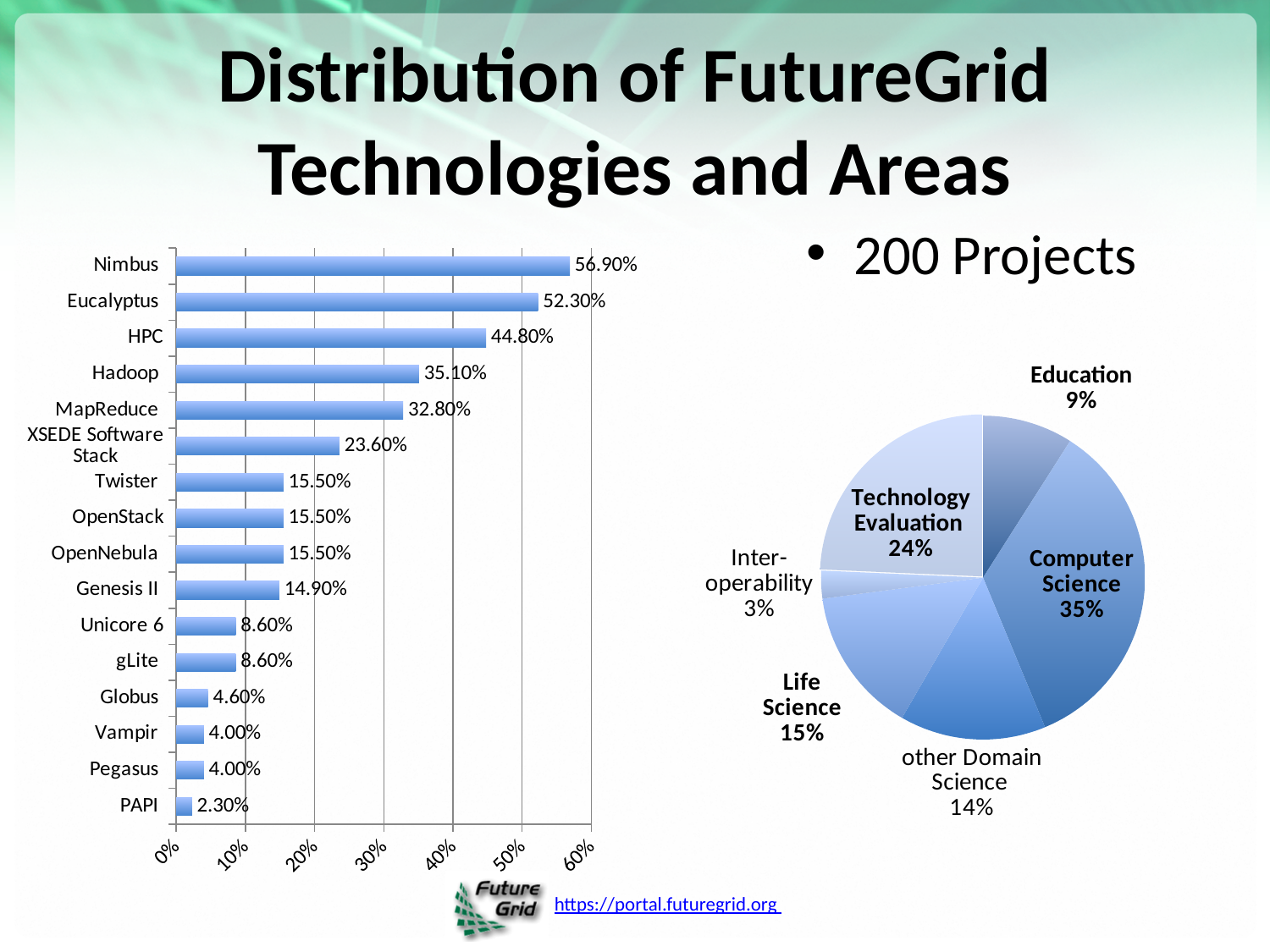
On the bar chart on the left of the slide, what is the value for XSEDE Software Stack? 23.60% What kind of chart is shown on the left of the slide? Bar chart On the pie chart on the right of the slide, what share does Computer Science have? 35% On the bar chart on the left of the slide, which has a larger value, HPC or MapReduce? HPC On the bar chart on the left of the slide, what is the value for Hadoop? 35.10% On the bar chart on the left of the slide, what is the difference between the values for Nimbus and Eucalyptus? 4.60% On the pie chart on the right of the slide, which area has the smallest share? Interoperability On the pie chart on the right of the slide, what share does Technology Evaluation have? 24% On the pie chart on the right of the slide, how many slices are there? 6 On the bar chart on the left of the slide, which technology has the highest value? Nimbus On the bar chart on the left of the slide, which technology has the lowest value? PAPI On the bar chart on the left of the slide, how many technologies are listed? 16